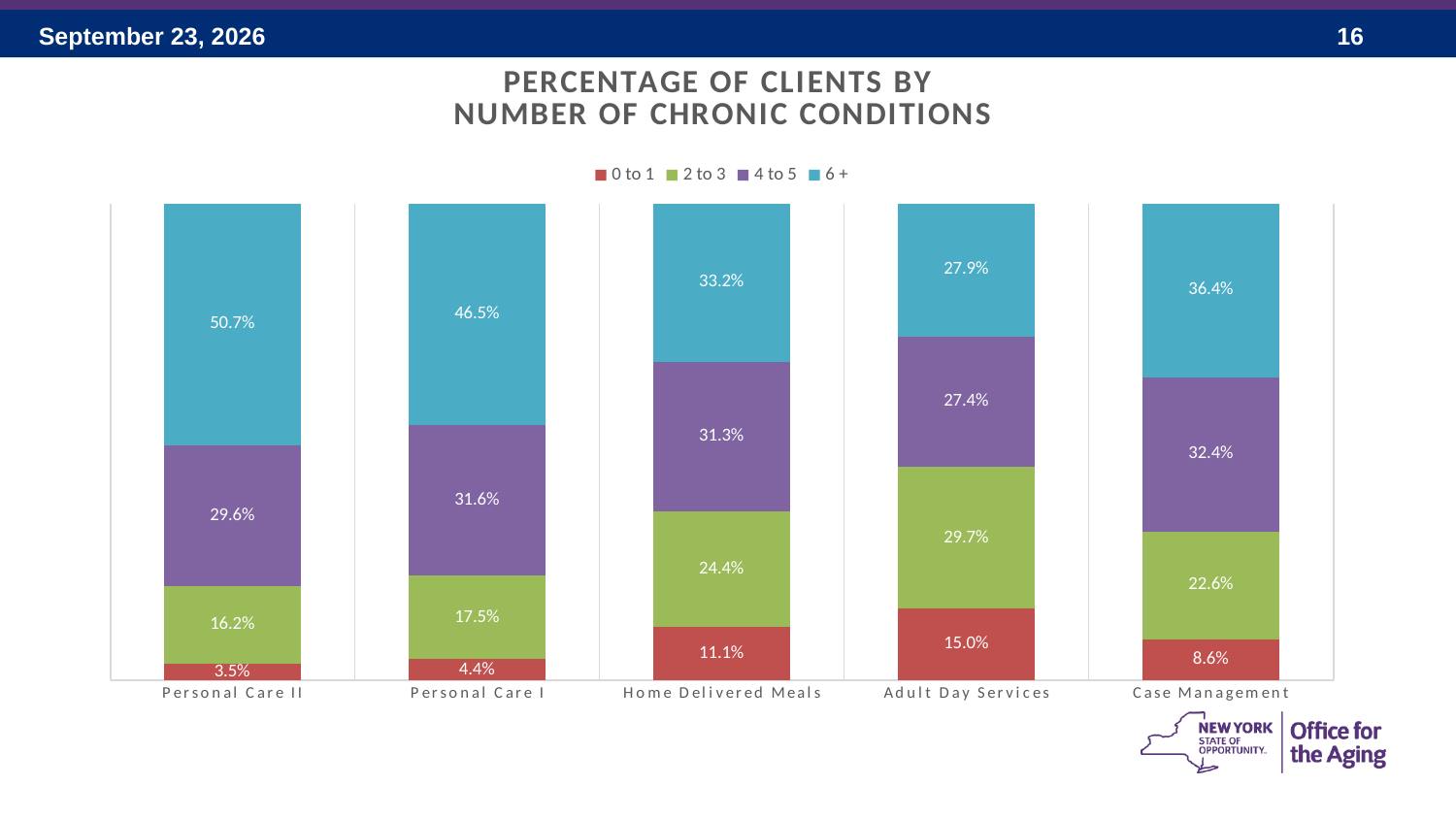
What percentage of Personal Care II clients have 6+ chronic conditions? 50.7% What is the value of the 0 to 1 segment for Adult Day Services? 15.0% What is the value of the 2 to 3 segment for Personal Care I? 17.5% Which program has the highest percentage of clients with 6+ chronic conditions? Personal Care II How many programs are shown on the x axis? 5 What is the total of the stacked bar for Home Delivered Meals? 100.0% What kind of chart is shown on the slide? Stacked bar chart What is the difference between the 4 to 5 value for Case Management and the 4 to 5 value for Personal Care II? 2.8 percentage points Which is larger: the 2 to 3 value for Home Delivered Meals or the 2 to 3 value for Case Management? Home Delivered Meals What is the title of the chart? Percentage of Clients by Number of Chronic Conditions Which program has the lowest percentage of clients with 0 to 1 chronic conditions? Personal Care II How many series does the legend list? 4